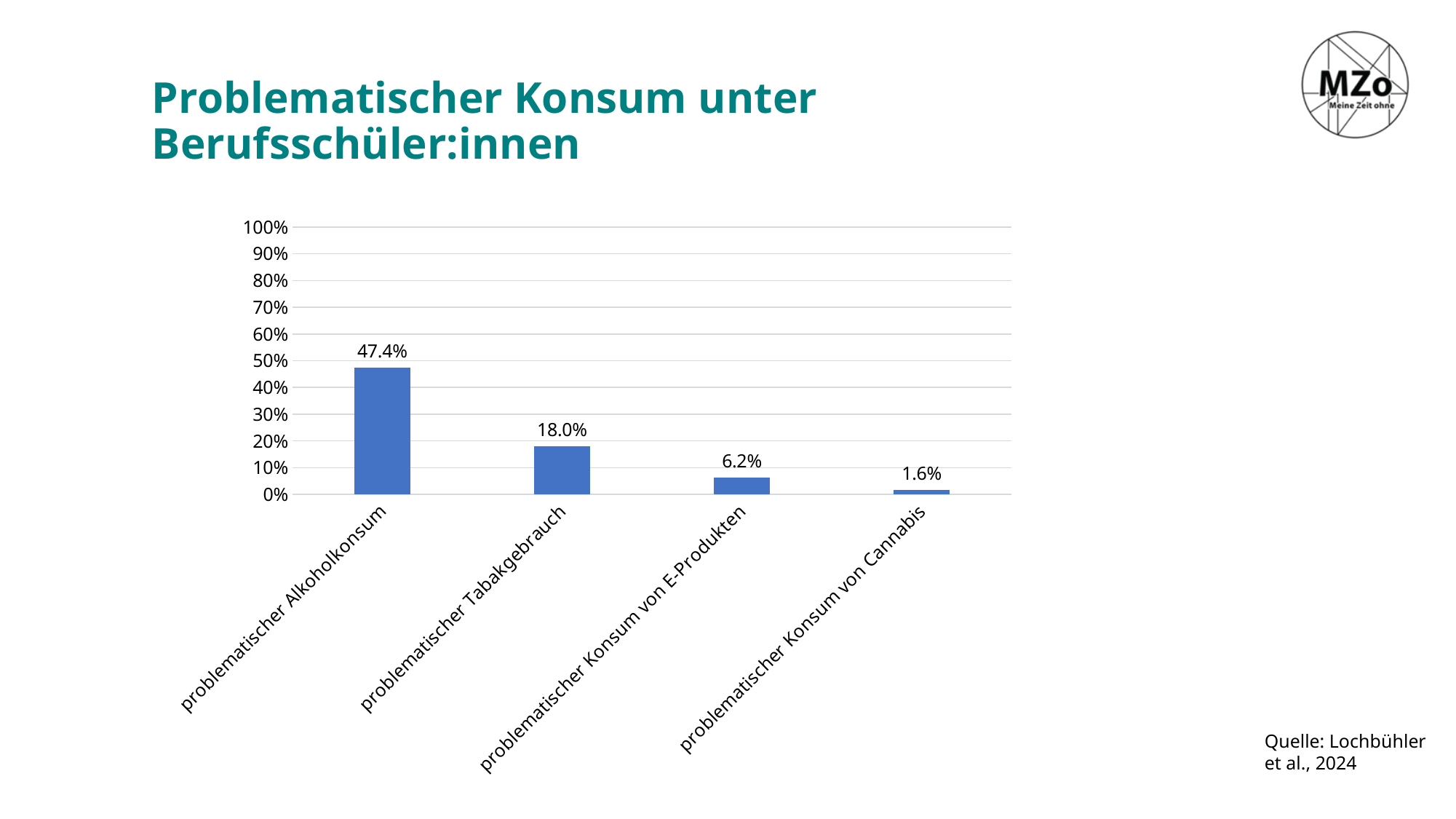
What is the value for problematischer Konsum von Cannabis? 1.6% Which category has the lowest value? problematischer Konsum von Cannabis What is the value for problematischer Konsum von E-Produkten? 6.2% Which category has the highest value? problematischer Alkoholkonsum What is the value for problematischer Alkoholkonsum? 47.4% How many categories are shown in the chart? 4 Do the values rise or fall from left to right along the x axis? fall What kind of chart is shown on the slide? bar chart Is the value for problematischer Alkoholkonsum greater or less than 50%? less Which is larger, the value for problematischer Tabakgebrauch or the value for problematischer Konsum von E-Produkten? problematischer Tabakgebrauch What is the value for problematischer Tabakgebrauch? 18.0% What is the difference between the values for problematischer Alkoholkonsum and problematischer Tabakgebrauch? 29.4%